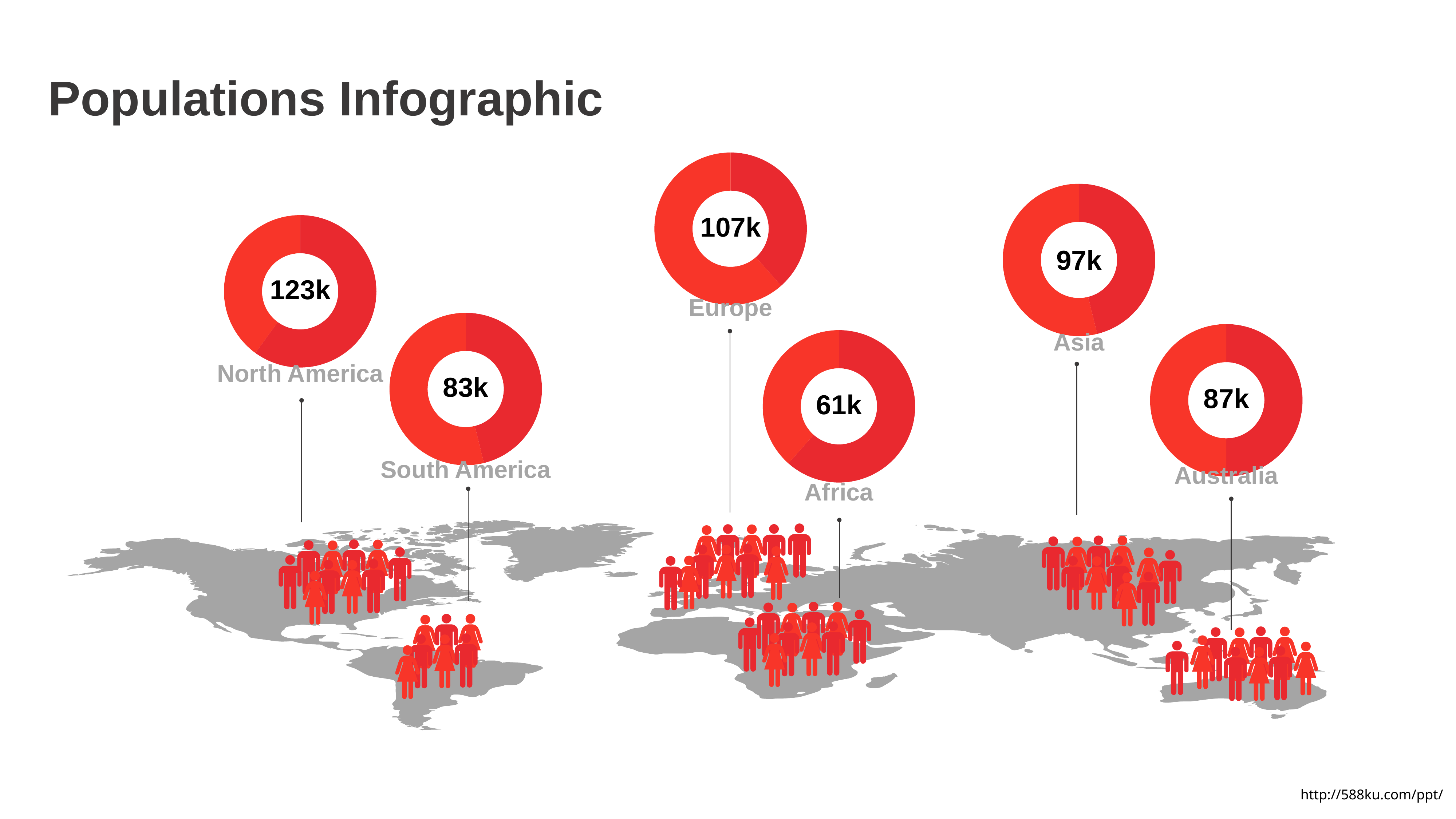
On the Australia donut chart, what value is shown in the centre? 87k On the Europe donut chart, what value is shown in the centre? 107k On the Africa donut chart, what value is shown in the centre? 61k On the Asia donut chart, what value is shown in the centre? 97k Comparing the Australia and South America donut charts, which region has the larger value? Australia Across all the donut charts on the slide, which region shows the highest value? North America On the North America donut chart, what value is shown in the centre? 123k What kind of chart is used for each region on the slide? Donut chart On the South America donut chart, what value is shown in the centre? 83k Across all the donut charts on the slide, which region shows the lowest value? Africa Comparing the Europe and Asia donut charts, what is the difference between their values? 10k How many donut charts are shown on the slide? 6